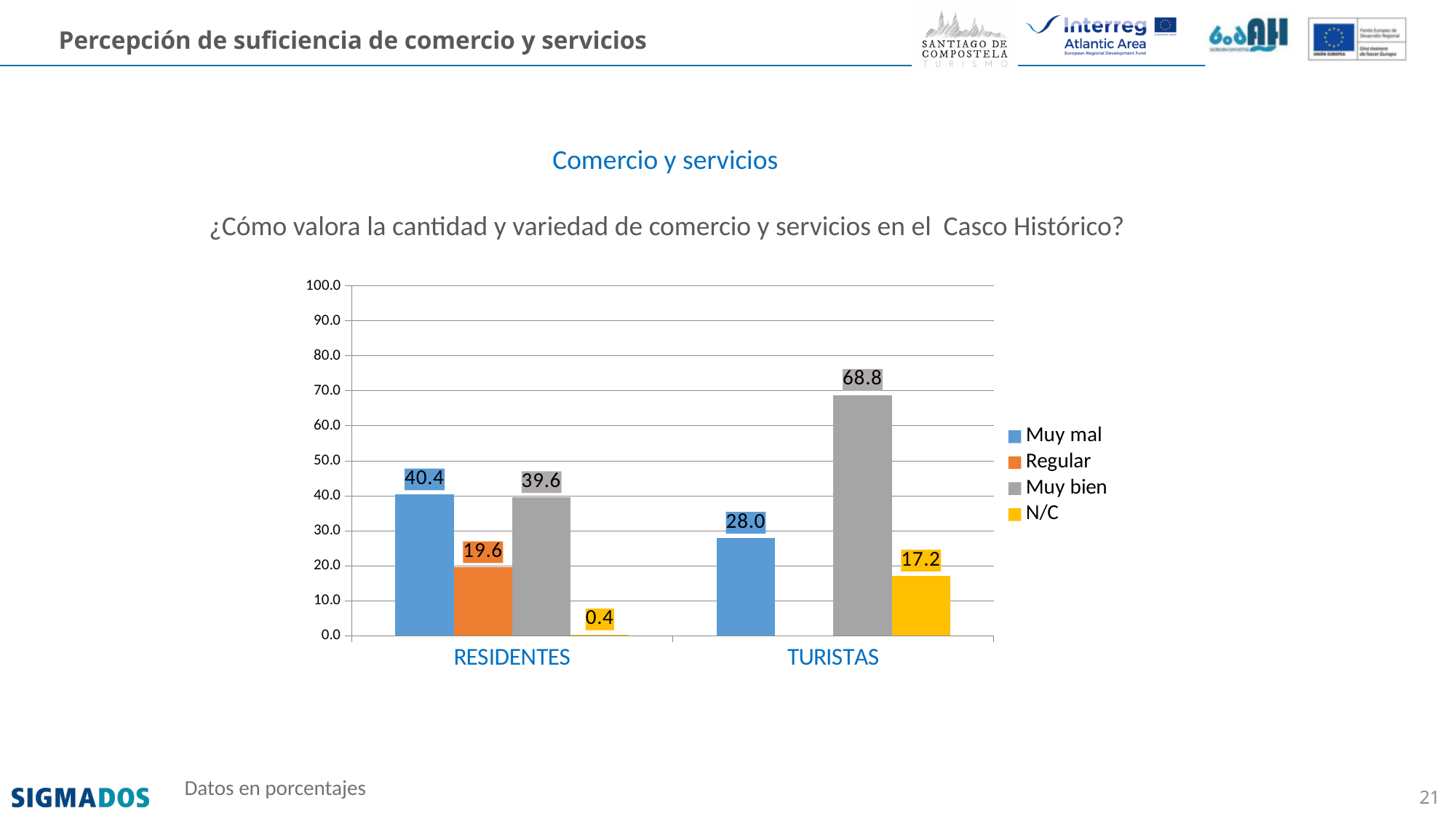
What is the value for Regular among RESIDENTES? 19.6 What is the difference between the Muy bien values for TURISTAS and RESIDENTES? 29.2 How many series does the legend list? 4 Which series has the highest value for TURISTAS? Muy bien What is the value for Muy mal among RESIDENTES? 40.4 Which series has the lowest value for RESIDENTES? N/C What is the value for Muy bien among TURISTAS? 68.8 What kind of chart is shown on the slide? Bar chart Is the value for Muy mal among TURISTAS greater or less than 30.0? less How many categories are shown on the x axis? 2 Which is larger for RESIDENTES: Muy mal or Regular? Muy mal What is the value for N/C among TURISTAS? 17.2